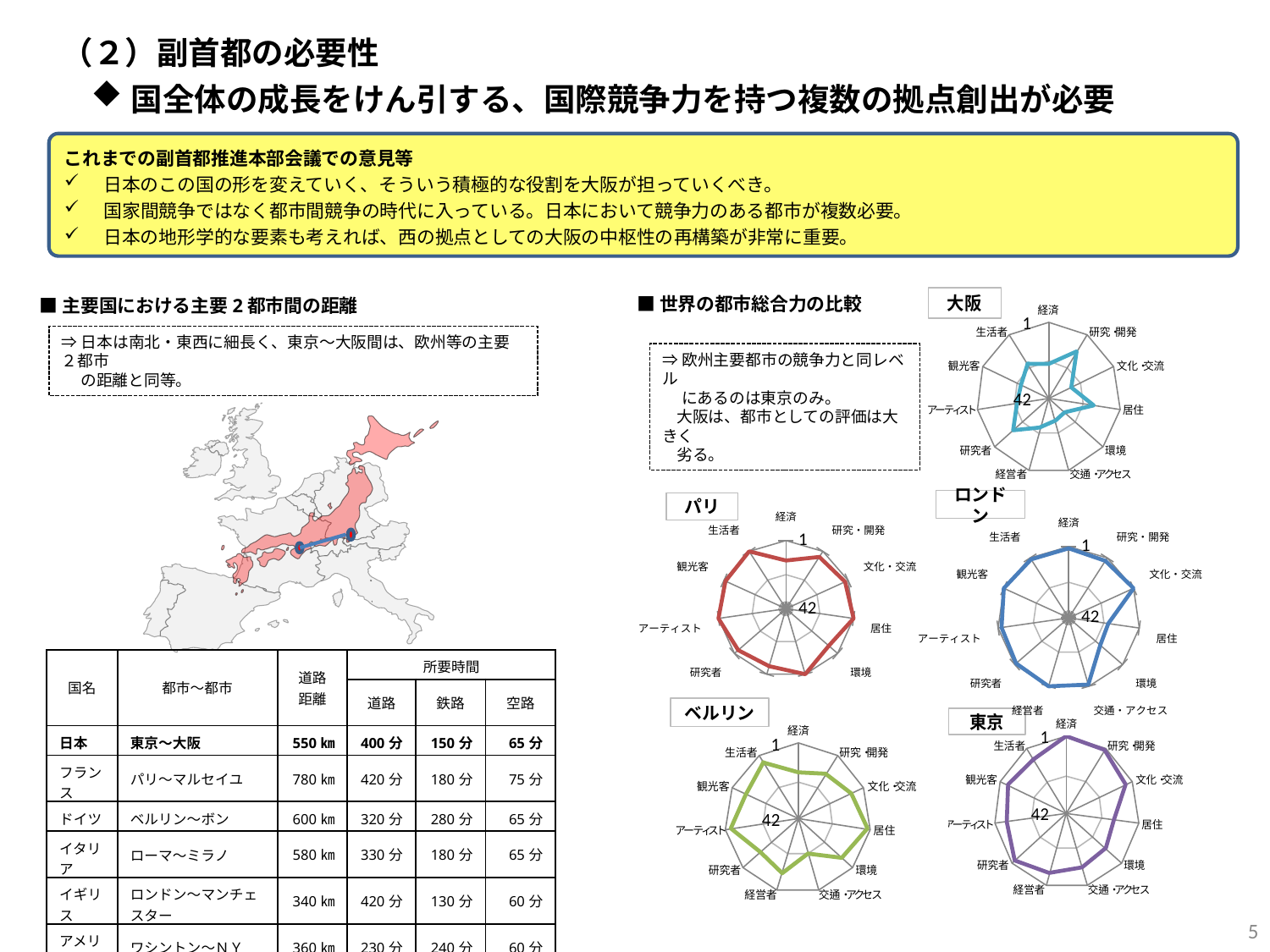
How many axes does the 東京 radar chart have? 11 What colour is the plotted line in the 東京 radar chart? purple What kind of chart is the 大阪 chart under 世界の都市総合力の比較? radar chart How many radar charts are shown under 世界の都市総合力の比較? 5 Which cities are shown in the radar charts under 世界の都市総合力の比較? 大阪, パリ, ロンドン, ベルリン, 東京 What value is printed at the centre of the ロンドン radar chart? 42 How many axes (categories) does the パリ radar chart have? 11 What value is printed at the outer end of the 経済 axis in the ベルリン radar chart? 1